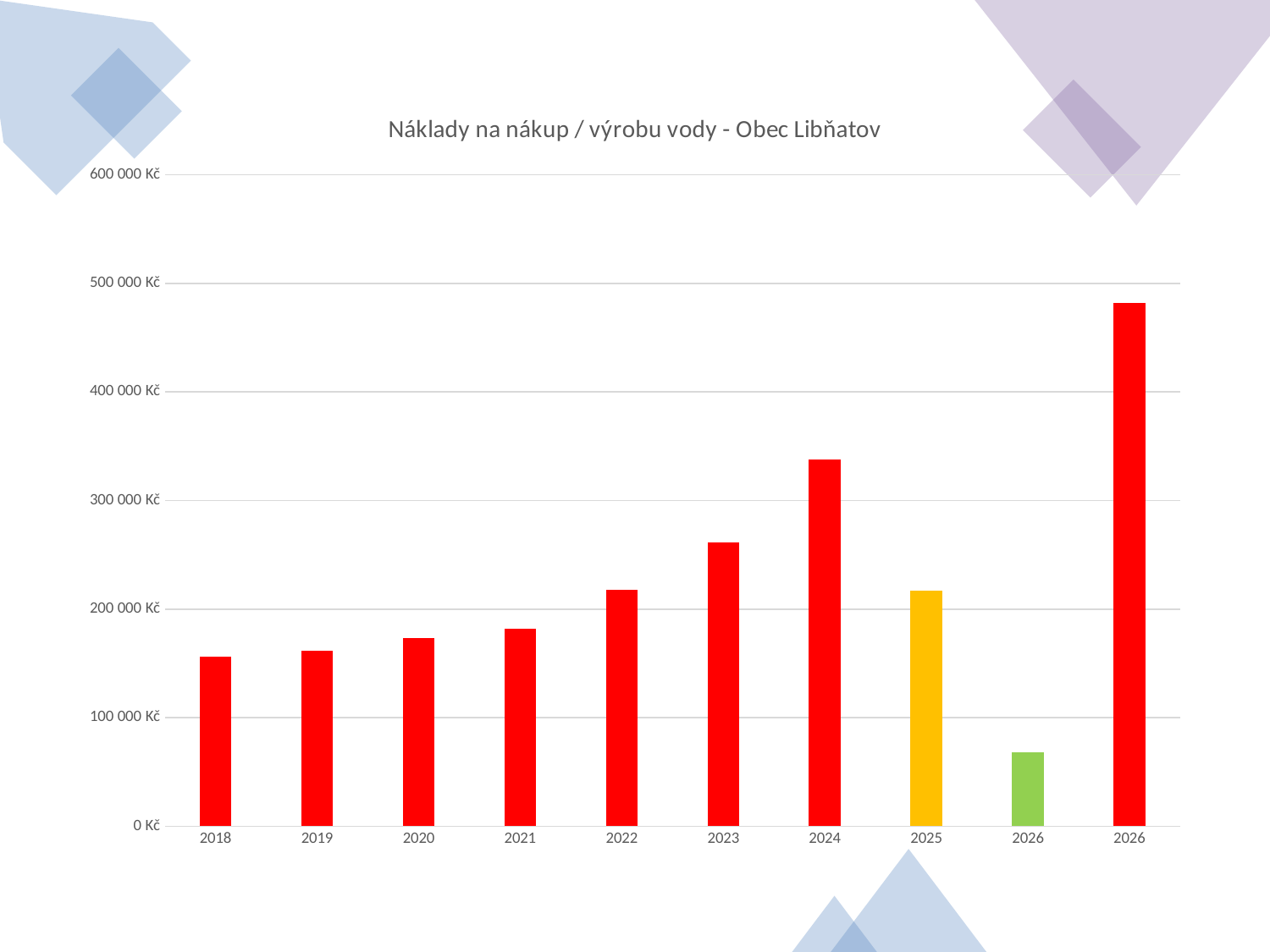
Is the value of the green 2026 bar greater or less than 100 000 Kč? less Is the value for 2018 greater or less than 100 000 Kč? greater Is the value for 2023 greater or less than 300 000 Kč? less What is the title of the chart? Náklady na nákup / výrobu vody - Obec Libňatov Do the values rise or fall from 2018 to 2024? rise Which bar has the lowest value? the green 2026 bar How many bars are plotted in the chart? 10 Which is larger, the value for 2023 or the value for 2024? 2024 What kind of chart is shown on the slide? bar chart Which bar has the highest value? the last 2026 bar (red)